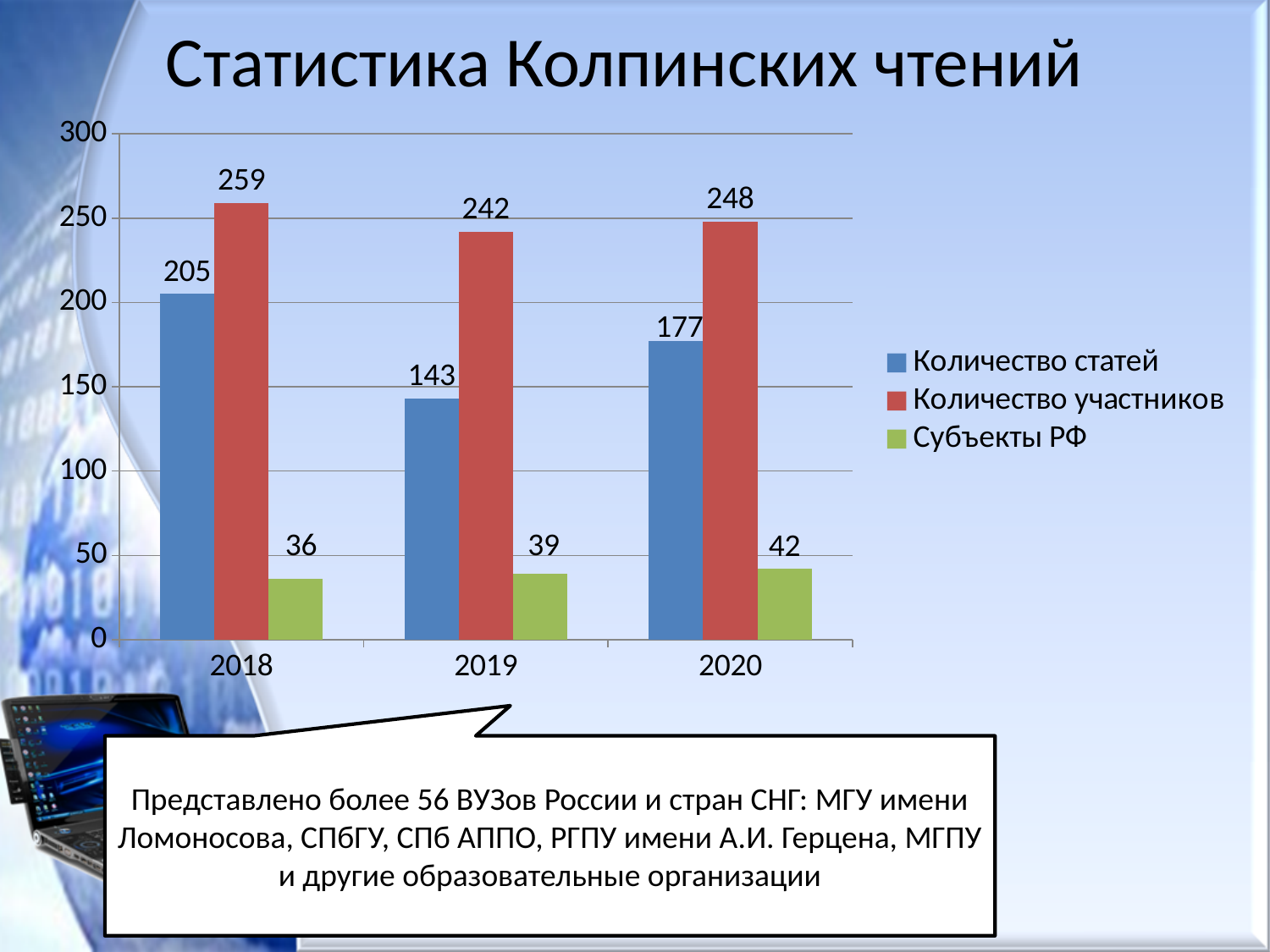
What is the value of Количество статей for 2018? 205 How many years are shown on the x axis? 3 Which is larger: Количество статей in 2018 or in 2020? 2018 Is the value of Количество статей for 2019 greater or less than 150? less What is the value of Субъекты РФ for 2020? 42 What is the difference between Количество участников and Количество статей in 2020? 71 What is the value of Количество участников for 2019? 242 Does the value of Субъекты РФ rise or fall from 2018 to 2020? rise In which year is Количество статей lowest? 2019 In which year is Количество участников highest? 2018 How many series does the legend list? 3 What kind of chart is shown on the slide? bar chart